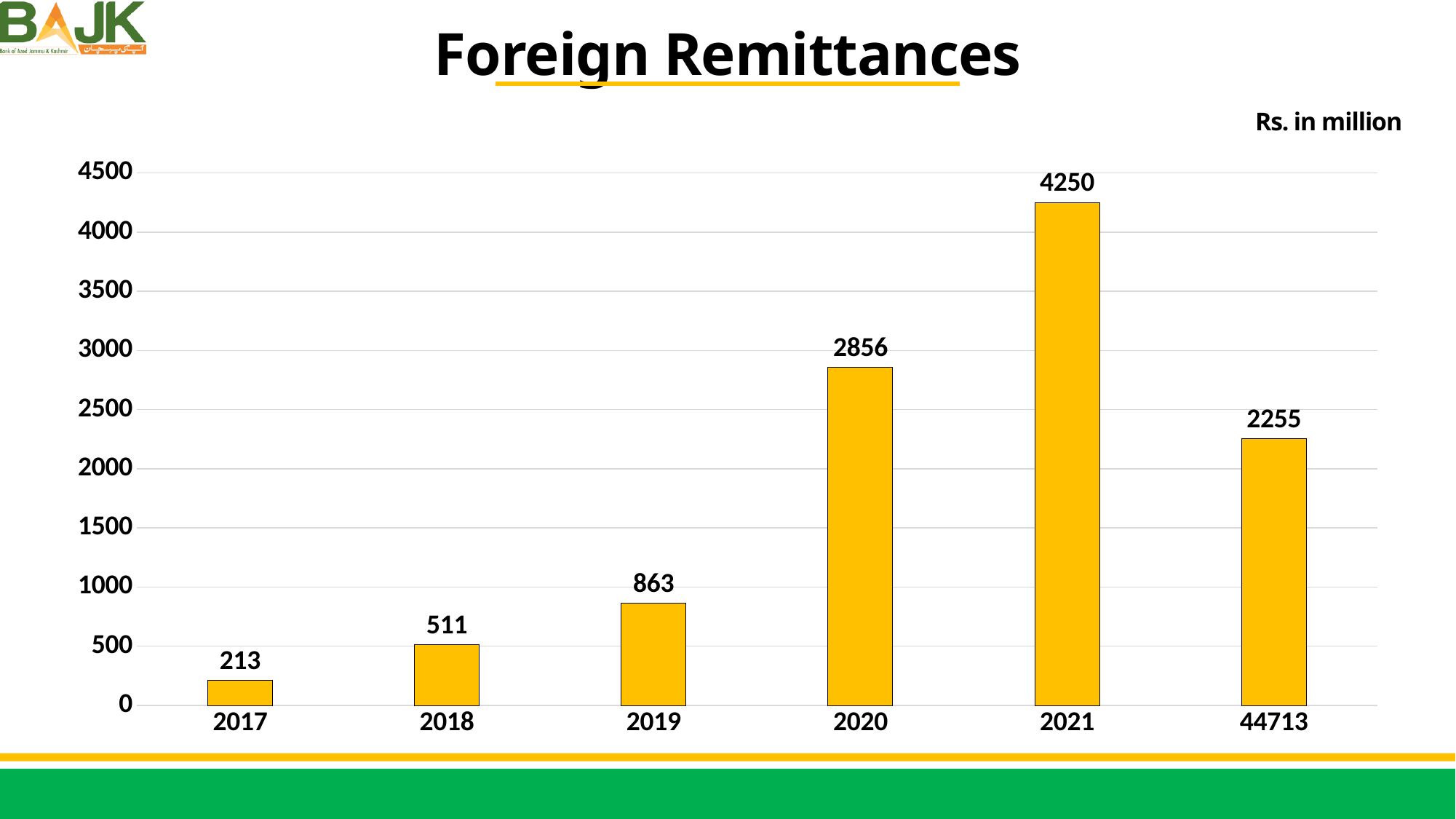
What is the value for 2020? 2856 How many categories are shown on the x axis? 6 Is the value for 2019 greater or less than 1000? less What is the difference between the values for 2021 and 2020? 1394 What unit is stated for the values on the chart? Rs. in million Which category has the highest value? 2021 What is the difference between the values for 2019 and 2018? 352 What is the value for 2017? 213 What kind of chart is shown on the slide? bar chart Which is larger, the value for 2020 or the value for the category labelled 44713? 2020 What is the value for the category labelled 44713? 2255 Which category has the lowest value? 2017